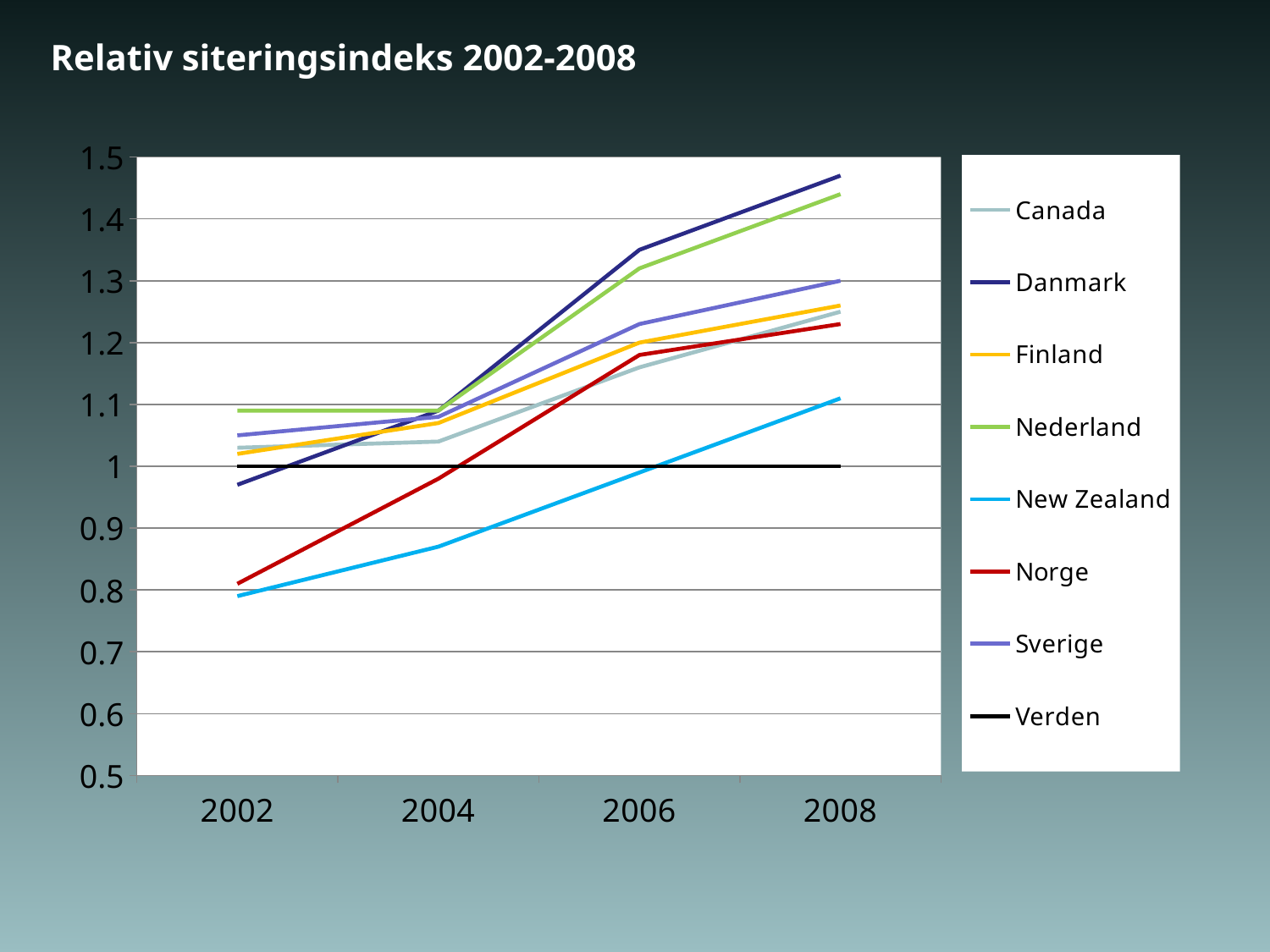
How many series does the legend list? 8 Which is larger in 2006, the value for Danmark or the value for New Zealand? Danmark Is the value for New Zealand in 2002 greater or less than 0.9? less Which series has the highest value in 2002? Nederland What is the value of the Verden line across all years? 1 What is the title of the chart? Relativ siteringsindeks 2002-2008 Which series has the lowest value in 2008? New Zealand How many years are shown on the x axis? 4 What kind of chart is shown on the slide? line chart Which series has the highest value in 2008? Danmark Is the value for Danmark in 2008 greater or less than 1.4? greater Does the New Zealand line rise or fall from 2002 to 2008? rise